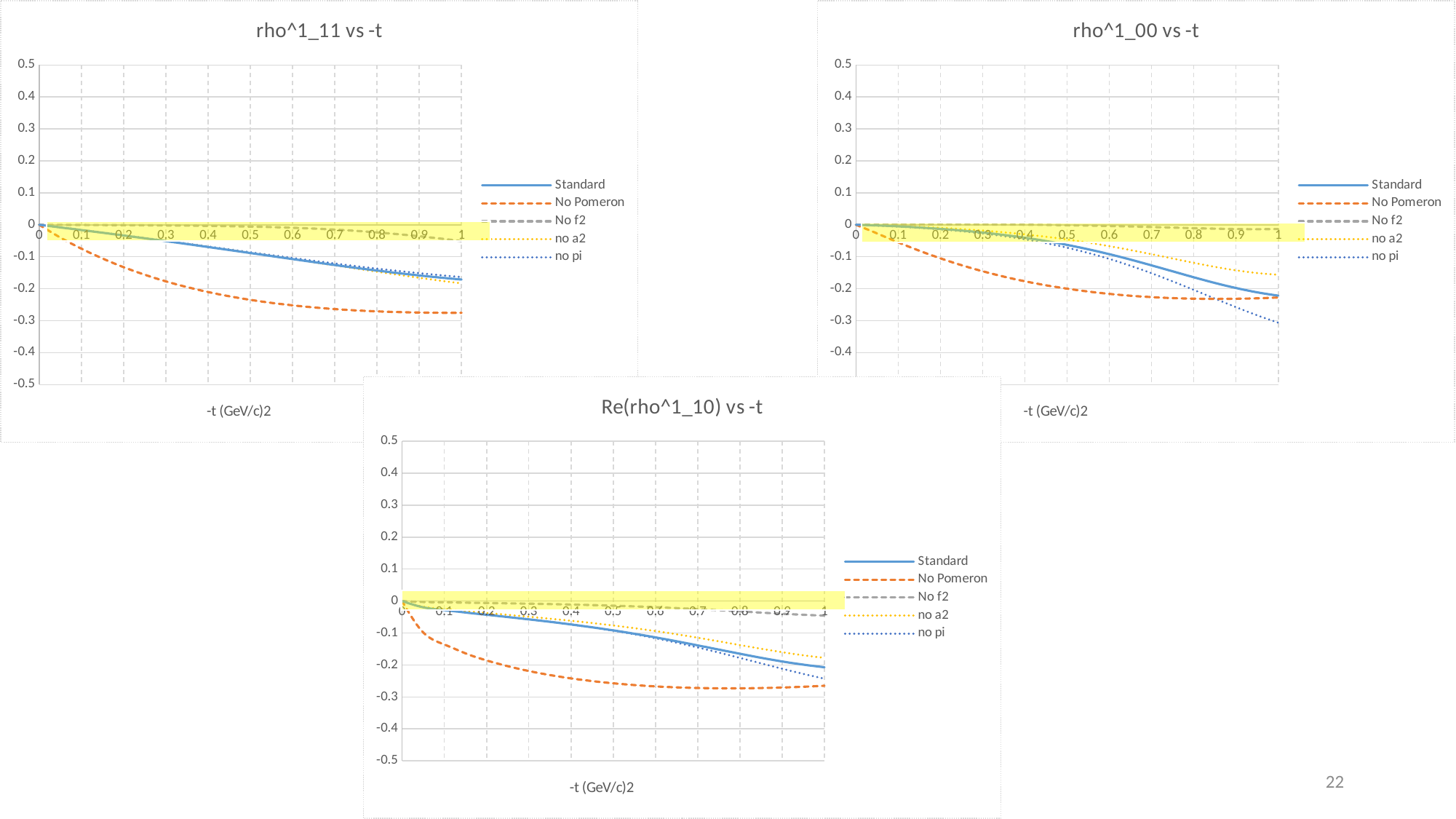
In the "Re(rho^1_10) vs -t" chart, is the value of the No Pomeron series at -t = 1 greater or less than -0.2? less In the "rho^1_00 vs -t" chart, which series is higher at -t = 1, no a2 or no pi? no a2 In the "rho^1_00 vs -t" chart, which series has the lowest value at -t = 1? no pi In the "rho^1_00 vs -t" chart, is the value of the no pi series at -t = 1 greater or less than -0.2? less Which series is drawn as an orange dashed line in the "rho^1_11 vs -t" chart? No Pomeron In the "rho^1_11 vs -t" chart, does the Standard series rise or fall as -t increases from 0 to 1? fall How many series does the legend of the "rho^1_00 vs -t" chart list? 5 In the "Re(rho^1_10) vs -t" chart, which series stays closest to 0 across the whole range of -t? No f2 In the "rho^1_11 vs -t" chart, is the value of the No Pomeron series at -t = 1 greater or less than -0.2? less What kind of chart is the one titled "rho^1_11 vs -t"? line chart In the "rho^1_11 vs -t" chart, which series is lowest at -t = 0.5, Standard or No Pomeron? No Pomeron What is the x-axis label of the "Re(rho^1_10) vs -t" chart? -t (GeV/c)2